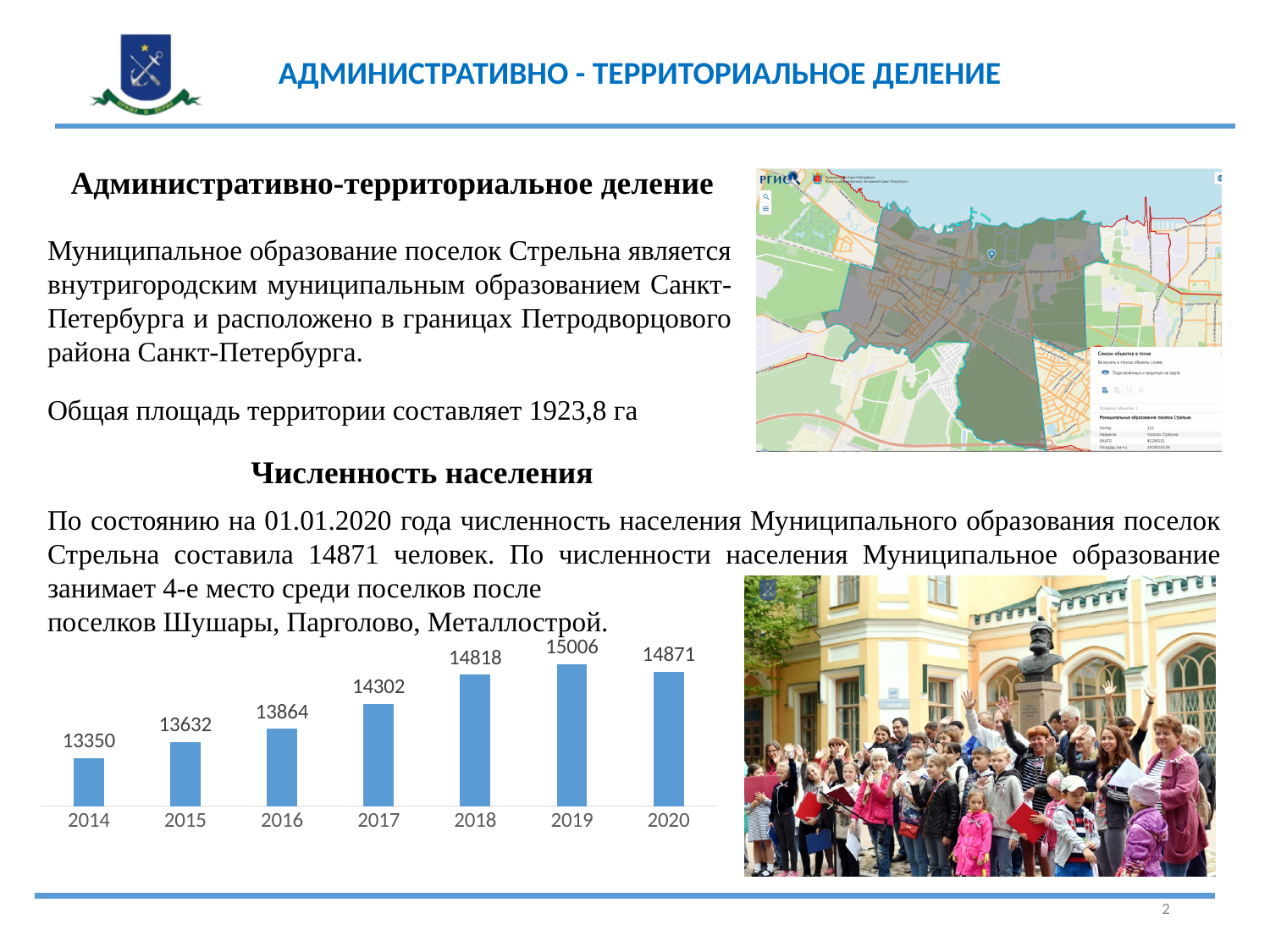
Which year has the lowest value in the bar chart? 2014 What is the value shown for 2014 in the bar chart? 13350 Which is larger in the bar chart, the value for 2016 or the value for 2018? 2018 Do the values in the bar chart rise or fall from 2014 to 2019? rise What is the value shown for 2017 in the bar chart? 14302 What is the difference between the values for 2018 and 2017 in the bar chart? 516 How many years are shown on the x axis of the bar chart? 7 What is the difference between the values for 2019 and 2020 in the bar chart? 135 What is the difference between the values for 2015 and 2014 in the bar chart? 282 What kind of chart is shown on the slide? bar chart Which year has the highest value in the bar chart? 2019 What is the value shown for 2020 in the bar chart? 14871